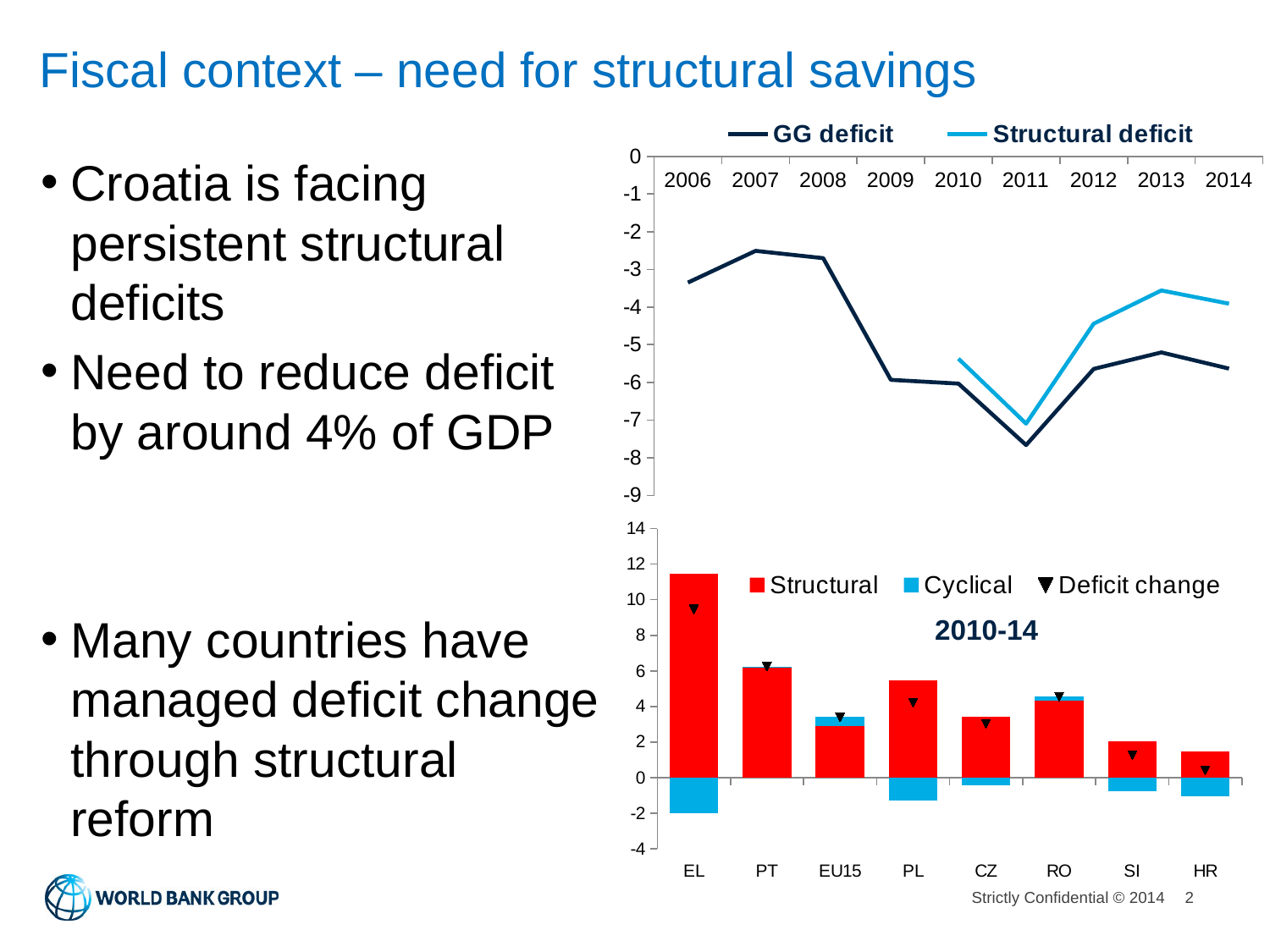
In the top chart, is the Structural deficit value for 2013 greater or less than -4? greater In the bottom chart (2010-14), is the Structural value for EL greater or less than 10? greater In the top chart, how many years are shown on the x axis? 9 In the top chart, is the GG deficit value for 2011 greater or less than -7? less In the bottom chart (2010-14), how many countries or groups are shown on the x axis? 8 In the bottom chart (2010-14), what kind of chart is it? bar chart In the top chart, in which year is the GG deficit at its highest (least negative) value? 2007 In the top chart, how many series does the legend list? 2 In the top chart, in which year is the GG deficit at its lowest (most negative) value? 2011 In the bottom chart (2010-14), which category has the highest Structural value? EL In the top chart, which series is drawn in light blue? Structural deficit In the top chart, what kind of chart is it? line chart